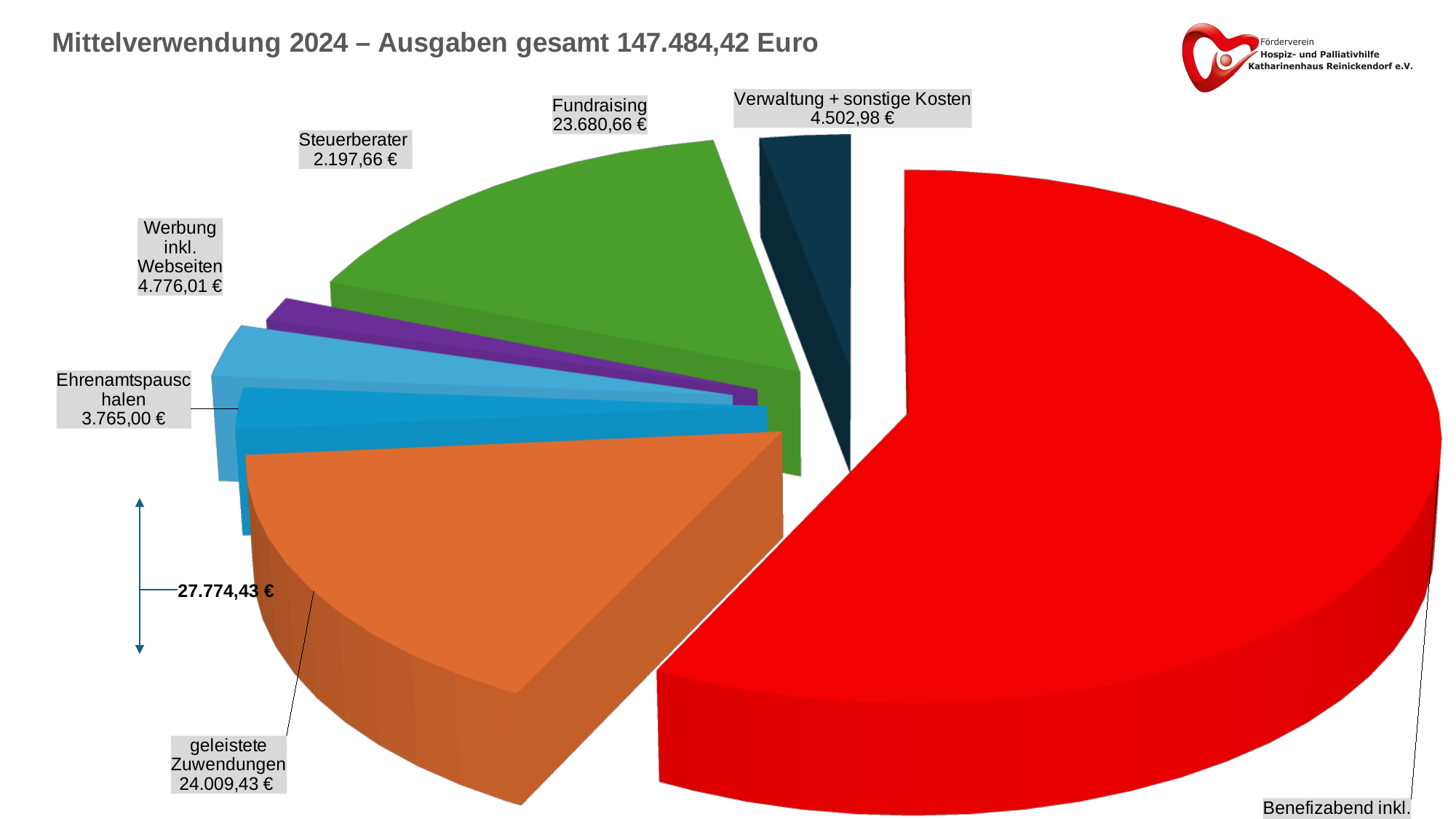
What is the value shown for Verwaltung + sonstige Kosten? 4.502,98 € What is the title of the chart? Mittelverwendung 2024 – Ausgaben gesamt 147.484,42 Euro Which is larger, Fundraising or geleistete Zuwendungen? geleistete Zuwendungen What is the value shown for Ehrenamtspauschalen? 3.765,00 € Which slice is the largest in the pie chart? Benefizabend inkl. What is the value shown for geleistete Zuwendungen? 24.009,43 € What is the value shown for Fundraising? 23.680,66 € What kind of chart is shown on the slide? Pie chart What is the difference between geleistete Zuwendungen and Fundraising? 328,77 € What is the difference between Werbung inkl. Webseiten and Verwaltung + sonstige Kosten? 273,03 € What is the value shown for Steuerberater? 2.197,66 € What is the value shown for Werbung inkl. Webseiten? 4.776,01 €